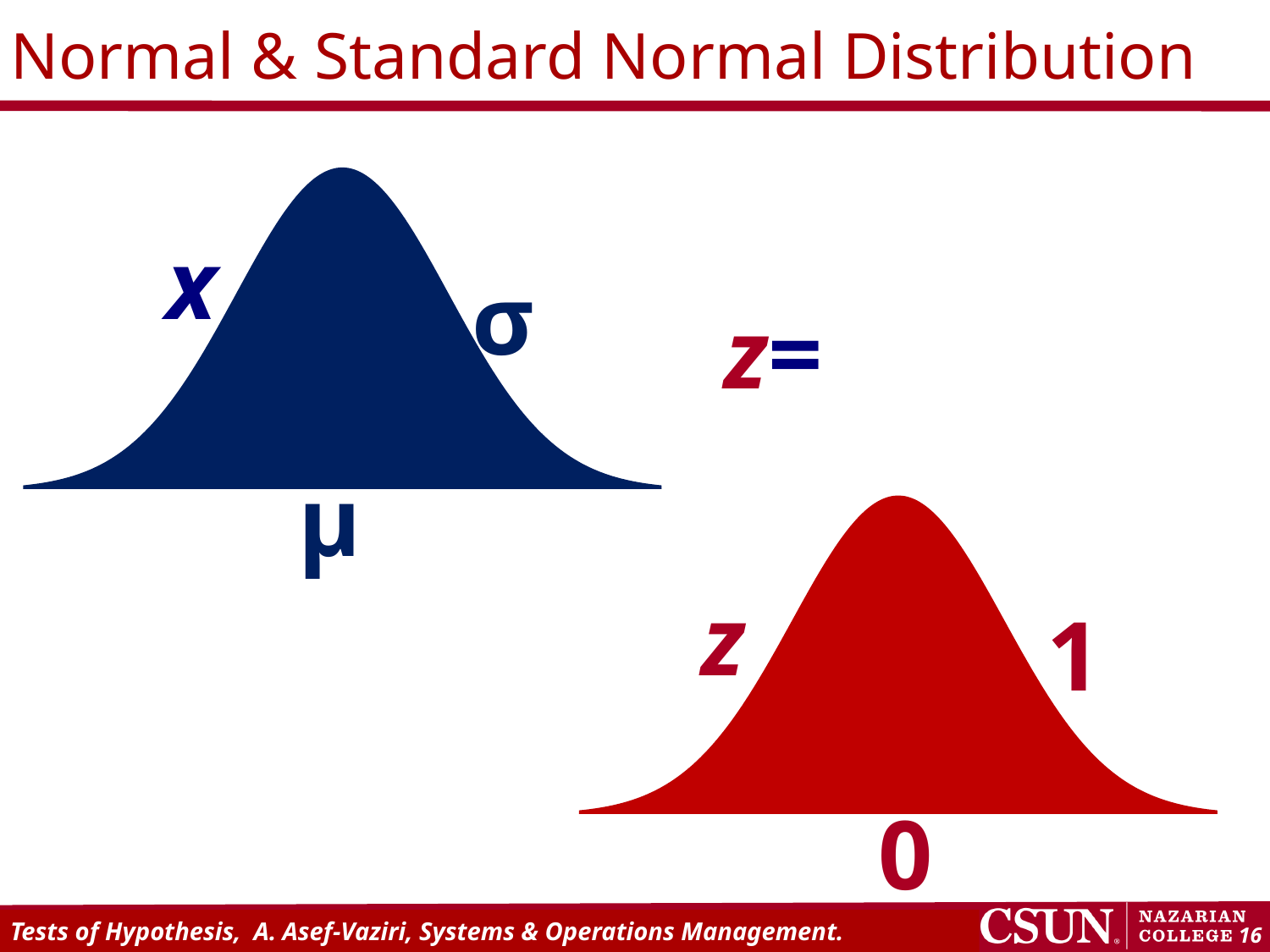
What value is labelled on the right side of the red standard normal curve? 1 What colour is the standard normal distribution curve labelled z? Red What is the title of the slide? Normal & Standard Normal Distribution What symbol is labelled on the right side of the blue normal curve? σ What kind of chart is shown on the slide? Bell-shaped normal distribution curves What value is labelled at the centre of the red standard normal curve? 0 What symbol is labelled at the centre of the blue normal curve? μ